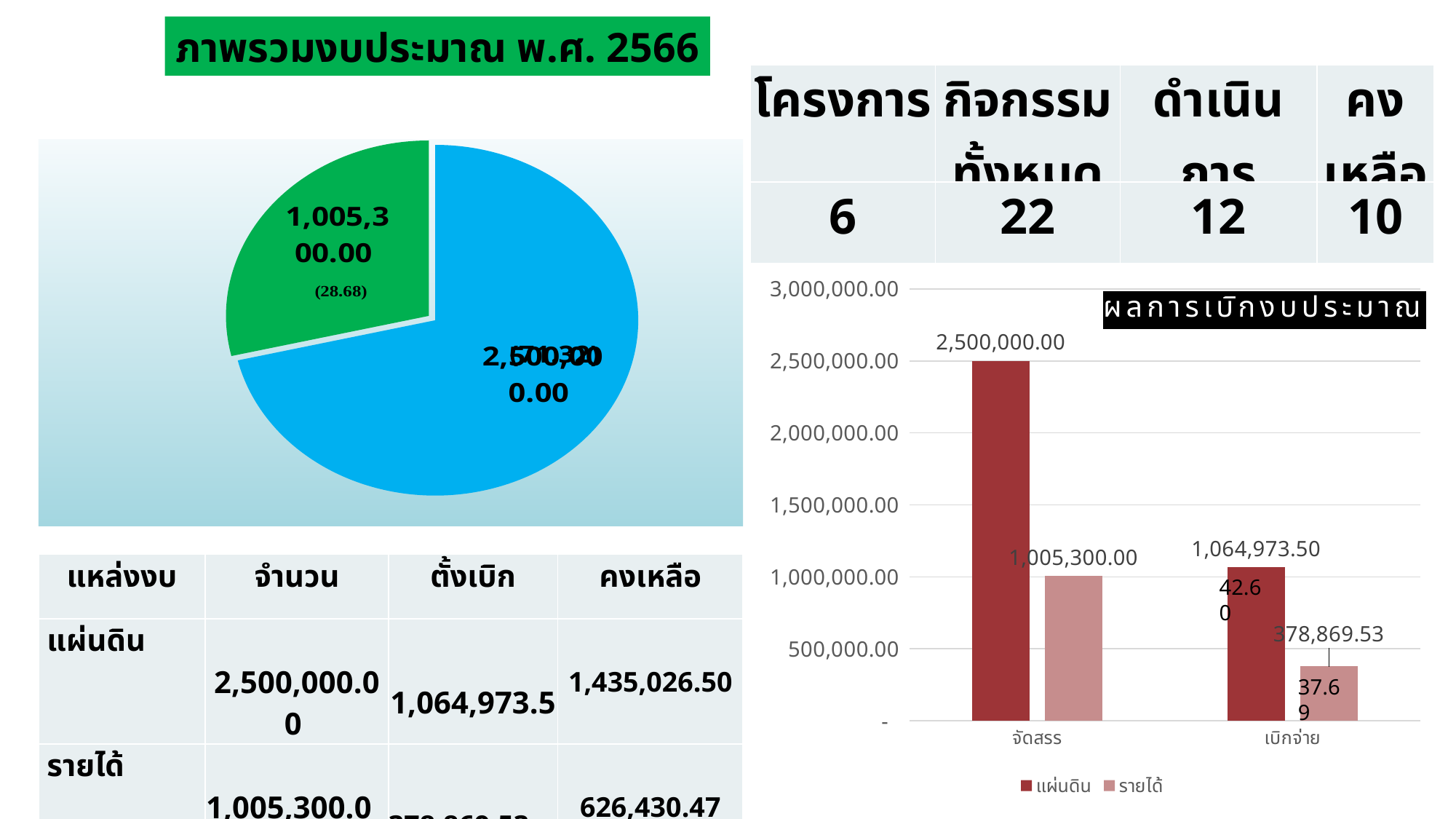
In the bar chart titled ผลการเบิกงบประมาณ, is the value of รายได้ for เบิกจ่าย greater or less than 500,000.00? less In the pie chart on the left of the slide, what value is labelled on the green slice? 1,005,300.00 In the bar chart titled ผลการเบิกงบประมาณ, which series has the higher value for เบิกจ่าย? แผ่นดิน In the bar chart titled ผลการเบิกงบประมาณ, how many categories are shown on the x axis? 2 In the bar chart titled ผลการเบิกงบประมาณ, what is the difference between the แผ่นดิน values for จัดสรร and เบิกจ่าย? 1,435,026.50 In the bar chart titled ผลการเบิกงบประมาณ, what is the value of รายได้ for เบิกจ่าย? 378,869.53 In the bar chart titled ผลการเบิกงบประมาณ, how many series does the legend list? 2 In the bar chart titled ผลการเบิกงบประมาณ, what is the value of แผ่นดิน for เบิกจ่าย? 1,064,973.50 What kind of chart is the chart titled ผลการเบิกงบประมาณ? bar chart What kind of chart is the chart on the left of the slide? pie chart In the bar chart titled ผลการเบิกงบประมาณ, what is the value of รายได้ for จัดสรร? 1,005,300.00 In the bar chart titled ผลการเบิกงบประมาณ, what is the value of แผ่นดิน for จัดสรร? 2,500,000.00